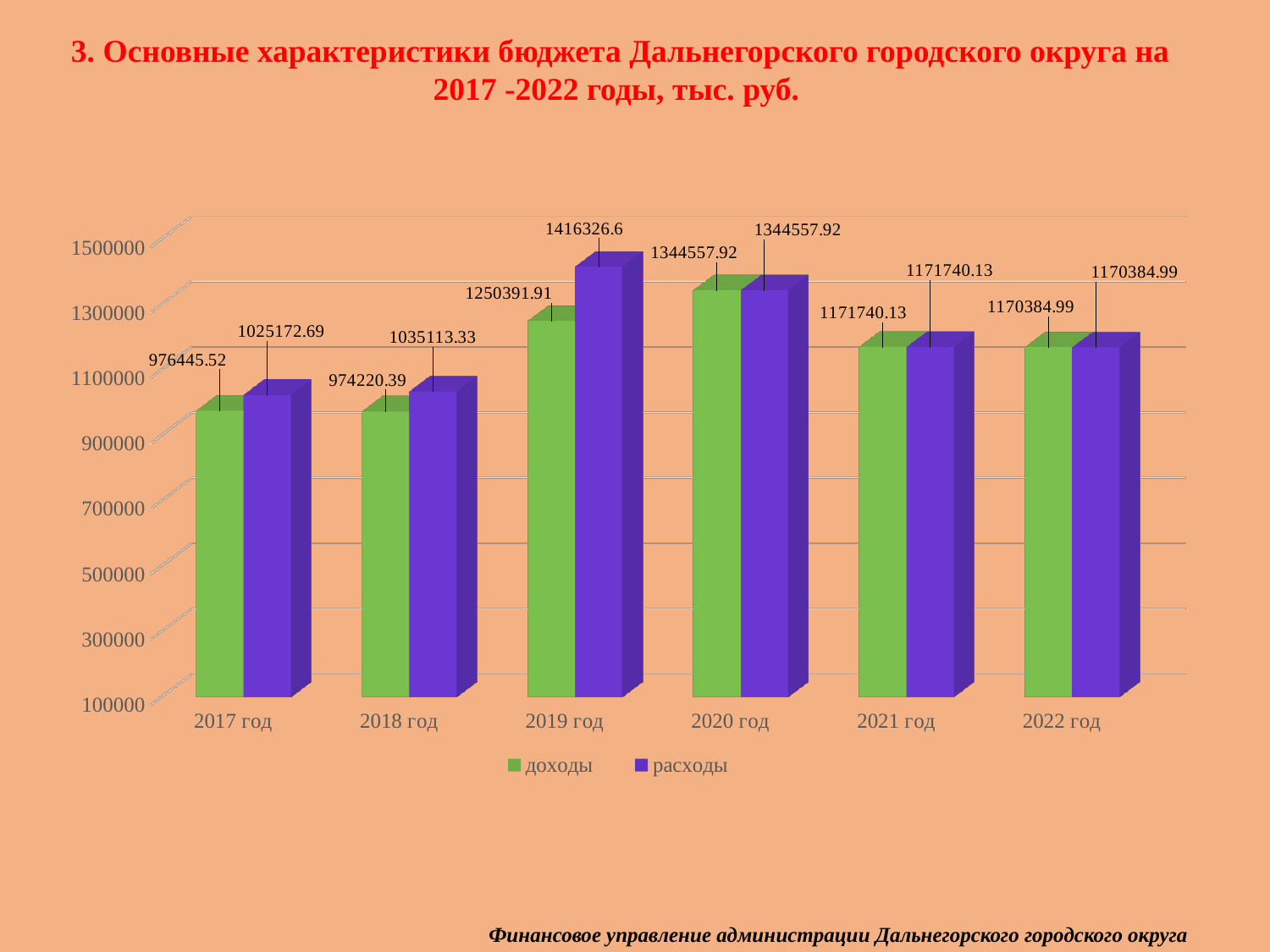
What is the value of расходы for 2018 год? 1035113.33 What kind of chart is shown on the slide? bar chart What is the value of доходы for 2017 год? 976445.52 How many years are shown on the x axis? 6 In which year is доходы the lowest? 2018 год What is the value of доходы for 2019 год? 1250391.91 Which is larger in 2018 год, доходы or расходы? расходы What is the difference between расходы and доходы in 2019 год? 165934.69 What is the difference between расходы and доходы in 2017 год? 48727.17 How many series does the legend list? 2 In which year is расходы the highest? 2019 год In which year is доходы the highest? 2020 год